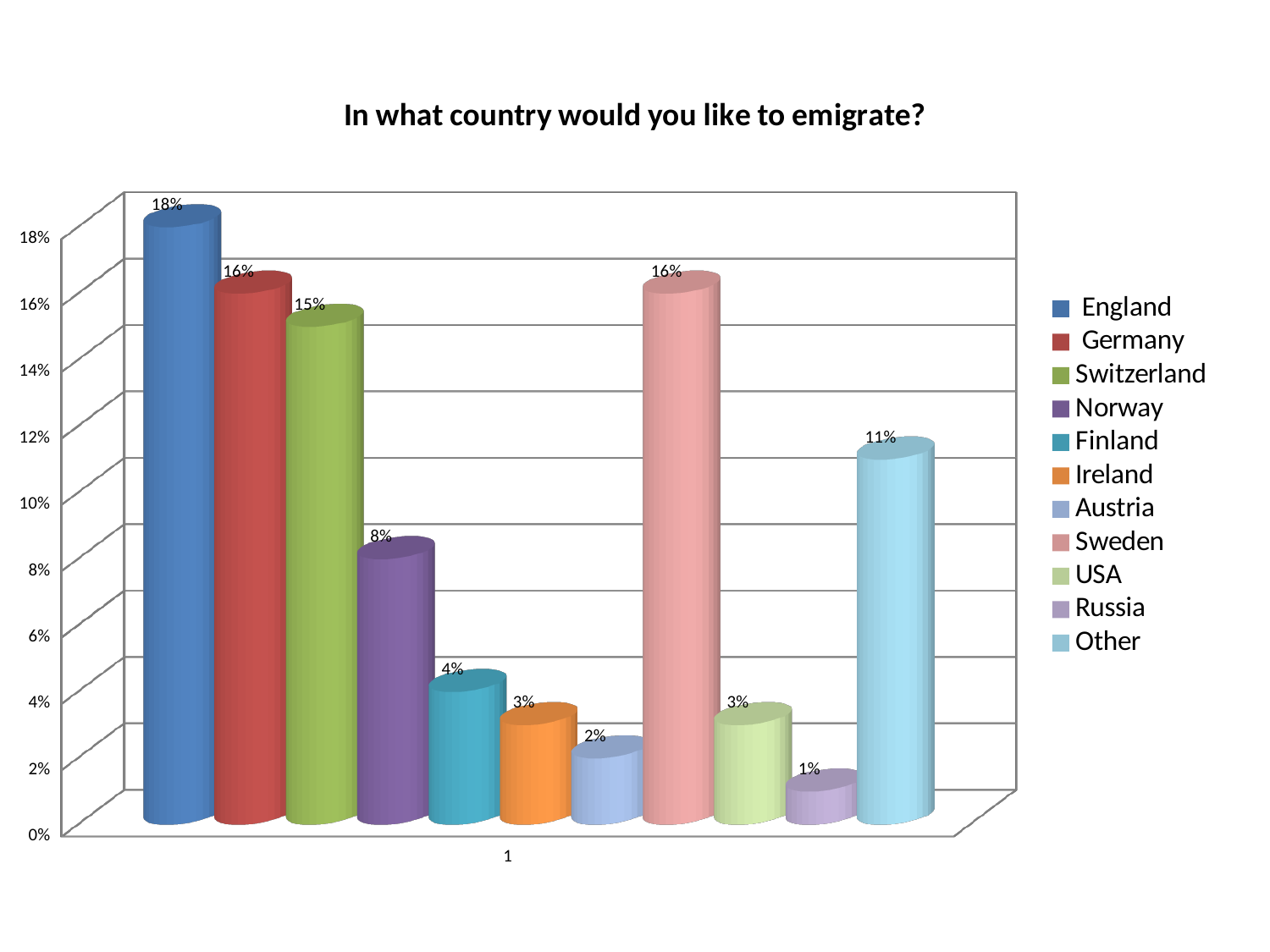
What is the title of the chart? In what country would you like to emigrate? What is the value for Sweden? 16% What is the difference between the values for England and Switzerland? 3% What kind of chart is shown on the slide? Bar chart What is the difference between the values for Finland and Austria? 2% Which country has the lowest value? Russia What is the value for Other? 11% What is the value for Norway? 8% How many series does the legend list? 11 Which country has the highest value? England Which is larger, the value for Norway or the value for Other? Other What is the value for England? 18%